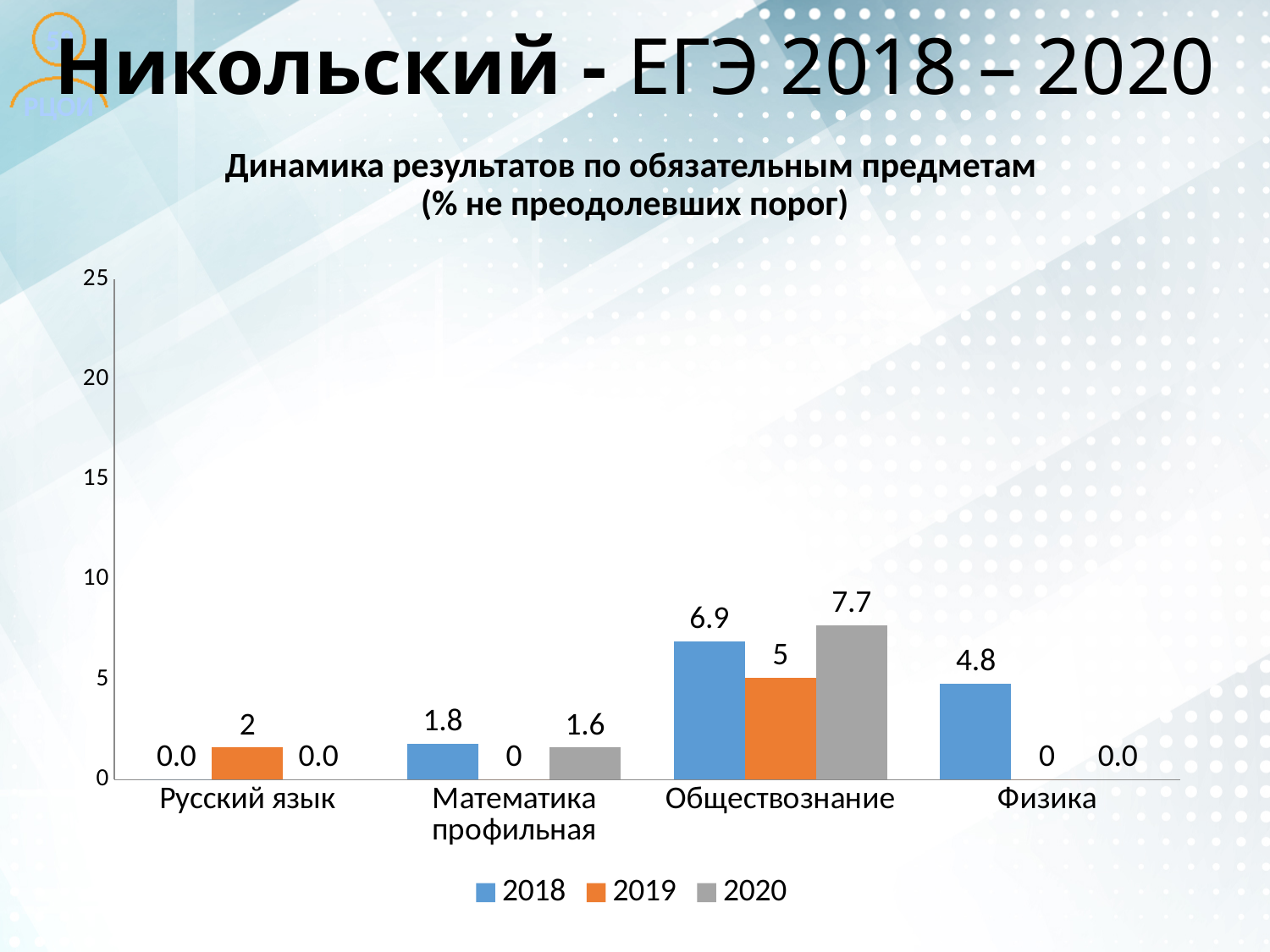
How many categories are shown on the x axis? 4 What is the value for Русский язык in 2019? 2 Do the values for Обществознание rise or fall from 2019 to 2020? Rise What is the value for Математика профильная in 2020? 1.6 What is the value for Обществознание in 2020? 7.7 What kind of chart is shown on the slide? Bar chart What is the difference between the 2020 and 2019 values for Обществознание? 2.7 Which category has the highest value in the 2018 series? Обществознание What is the value for Физика in 2018? 4.8 Which category has the lowest value in the 2019 series? Математика профильная and Физика (both 0) Which is larger for Математика профильная: the 2018 value or the 2020 value? 2018 How many series does the legend list? 3